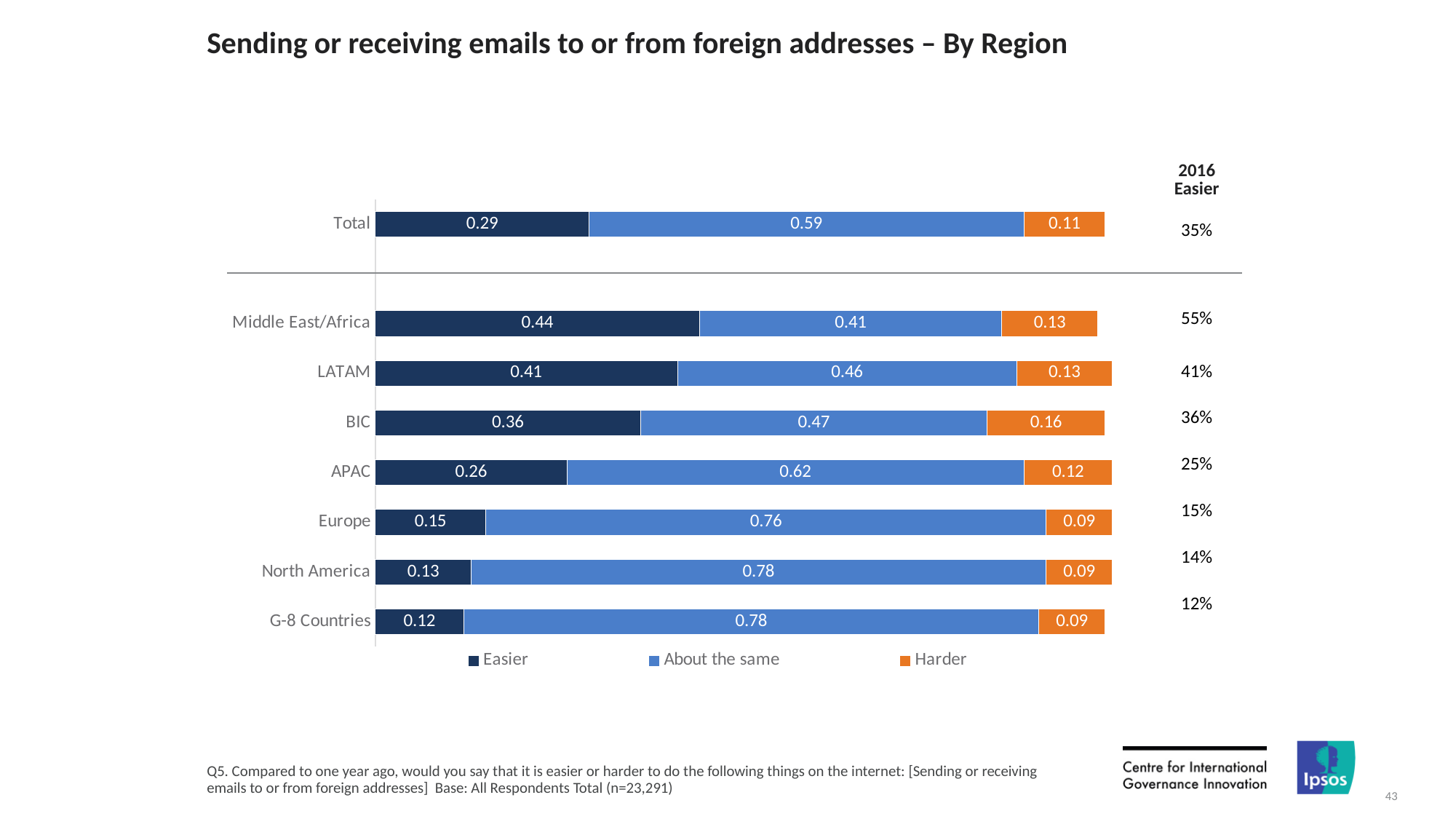
What is the difference between the 'About the same' values for Europe and APAC? 0.14 What kind of chart is shown on the slide? Stacked bar chart How many regions are shown in the chart, including Total? 8 What is the 'About the same' value for North America? 0.78 What is the 'Easier' value for Middle East/Africa? 0.44 What is the 2016 Easier percentage shown for APAC? 25% What is the total of the stacked bar for Total? 0.99 Which is larger, the 'Easier' value for LATAM or for BIC? LATAM Which region has the highest 'Easier' value? Middle East/Africa How many series does the legend list? 3 What is the 'Harder' value for BIC? 0.16 Which region has the lowest 'Easier' value? G-8 Countries